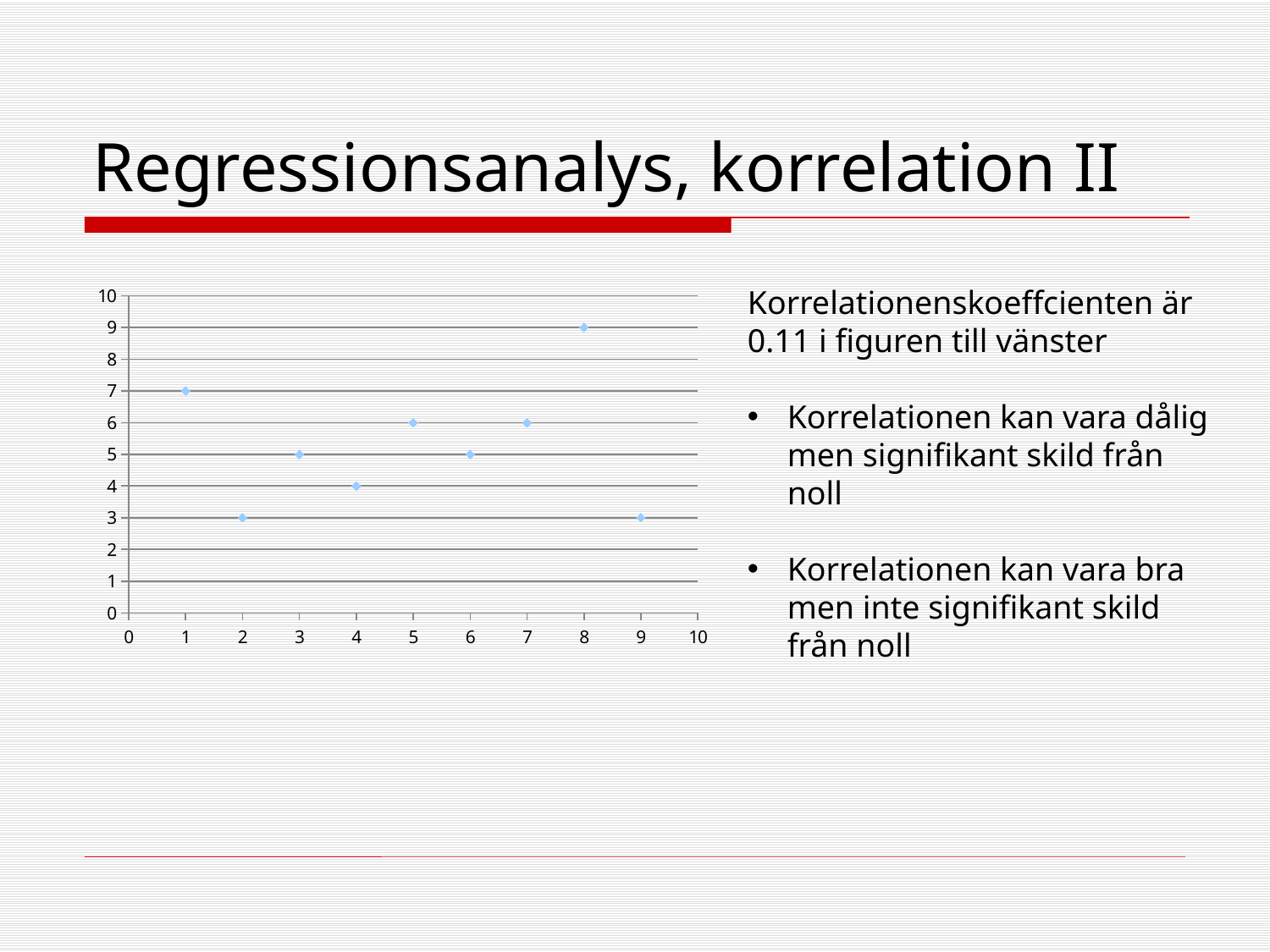
What is the y value of the point at x = 8? 9 What kind of chart is shown on the slide? scatter plot What is the lowest y value among the plotted points? 3 What is the title of the slide containing the chart? Regressionsanalys, korrelation II How many data points are plotted in the scatter chart? 9 What is the difference between the y value at x = 8 and the y value at x = 9? 6 What is the maximum value shown on the y axis? 10 At which x value does the point with the highest y value occur? 8 What is the y value of the point at x = 1? 7 What is the y value of the point at x = 4? 4 Is the y value of the point at x = 5 greater or less than 5? greater Which point has a larger y value, the one at x = 1 or the one at x = 2? x = 1